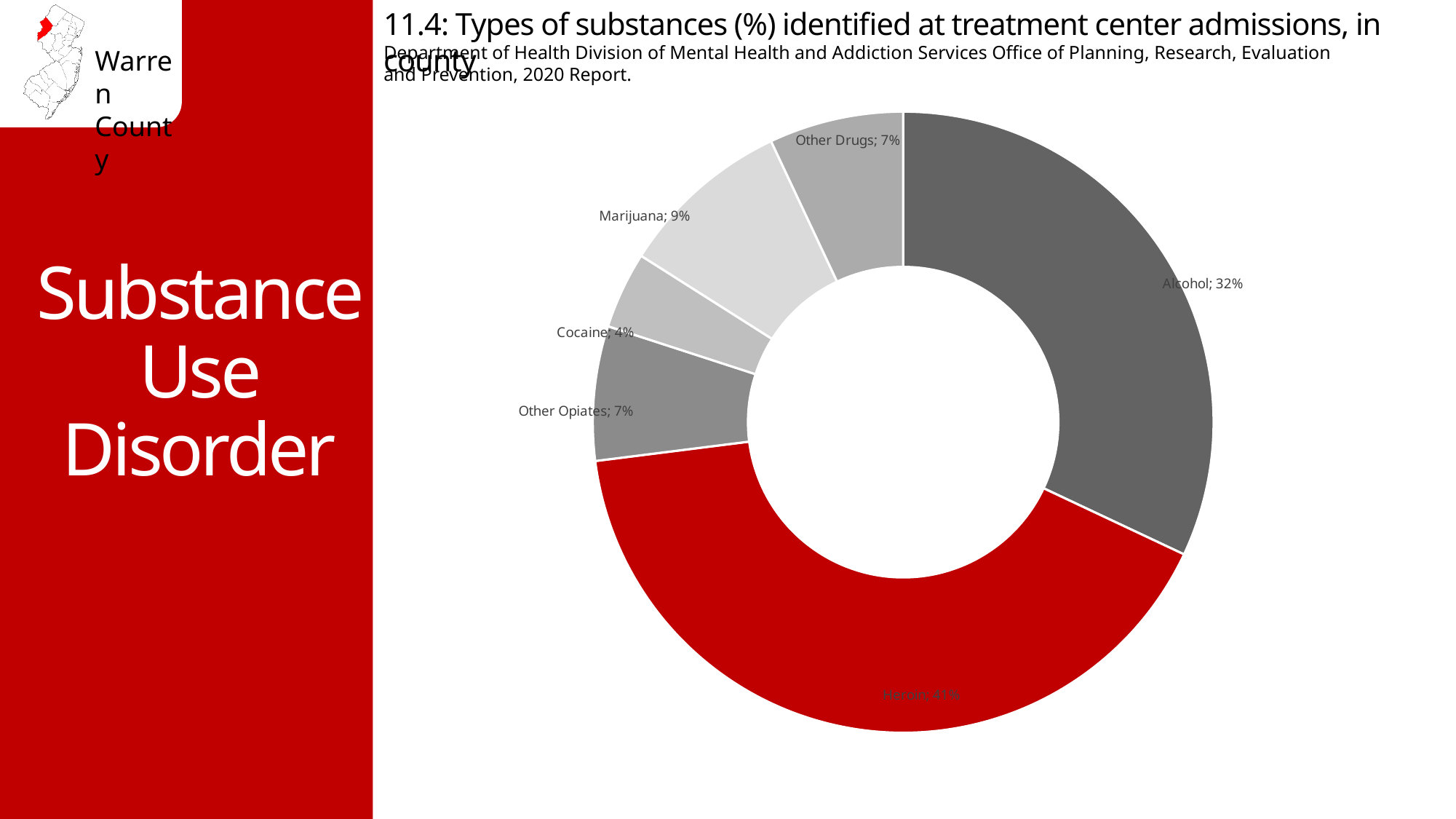
How many substance categories are shown in the chart? 6 Which has a larger share, Marijuana or Other Drugs? Marijuana What percentage is shown for Cocaine? 4% Which slice of the chart is coloured red? Heroin What is the difference in percentage points between Heroin and Alcohol? 9 Which substance has the largest share of admissions? Heroin What percentage is shown for Other Opiates? 7% What percentage is shown for Marijuana? 9% Which substance has the smallest share of admissions? Cocaine What percentage is shown for Heroin? 41% What type of chart is used on this slide? Doughnut (pie) chart What percentage of treatment center admissions is attributed to Alcohol? 32%